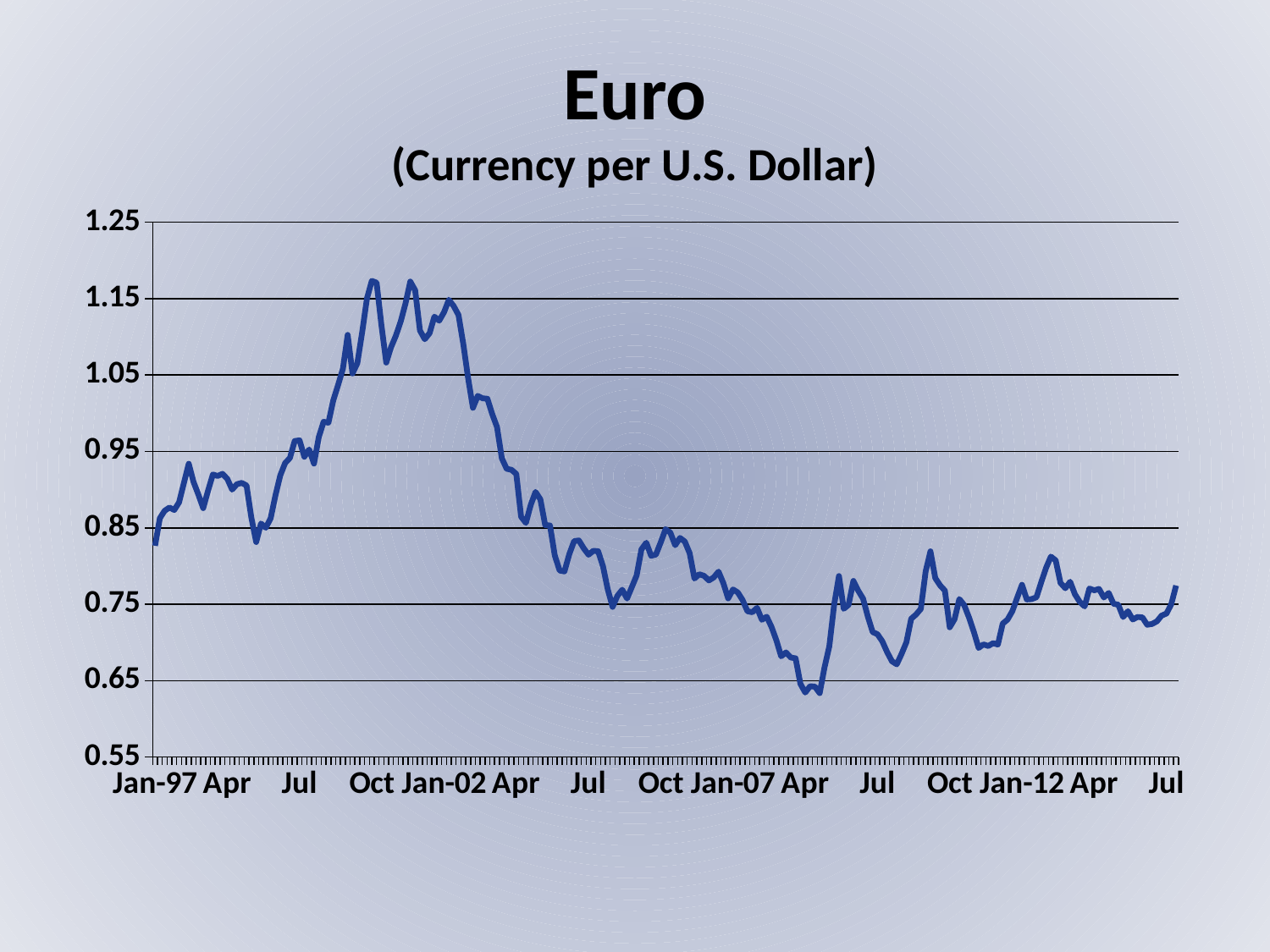
How many lines are plotted on the chart? 1 What is the title of the chart? Euro What unit does the chart's subtitle say the values are in? Currency per U.S. Dollar Is the value at Jan-12 greater or less than 0.65? greater Is the lowest point on the line greater or less than 0.75? less What kind of chart is shown on the slide? line chart Does the line generally rise or fall between Jan-97 and Jan-02? rise Is the value at Jan-02 greater or less than 1.05? greater Does the line generally rise or fall between Jan-02 and Jan-07? fall